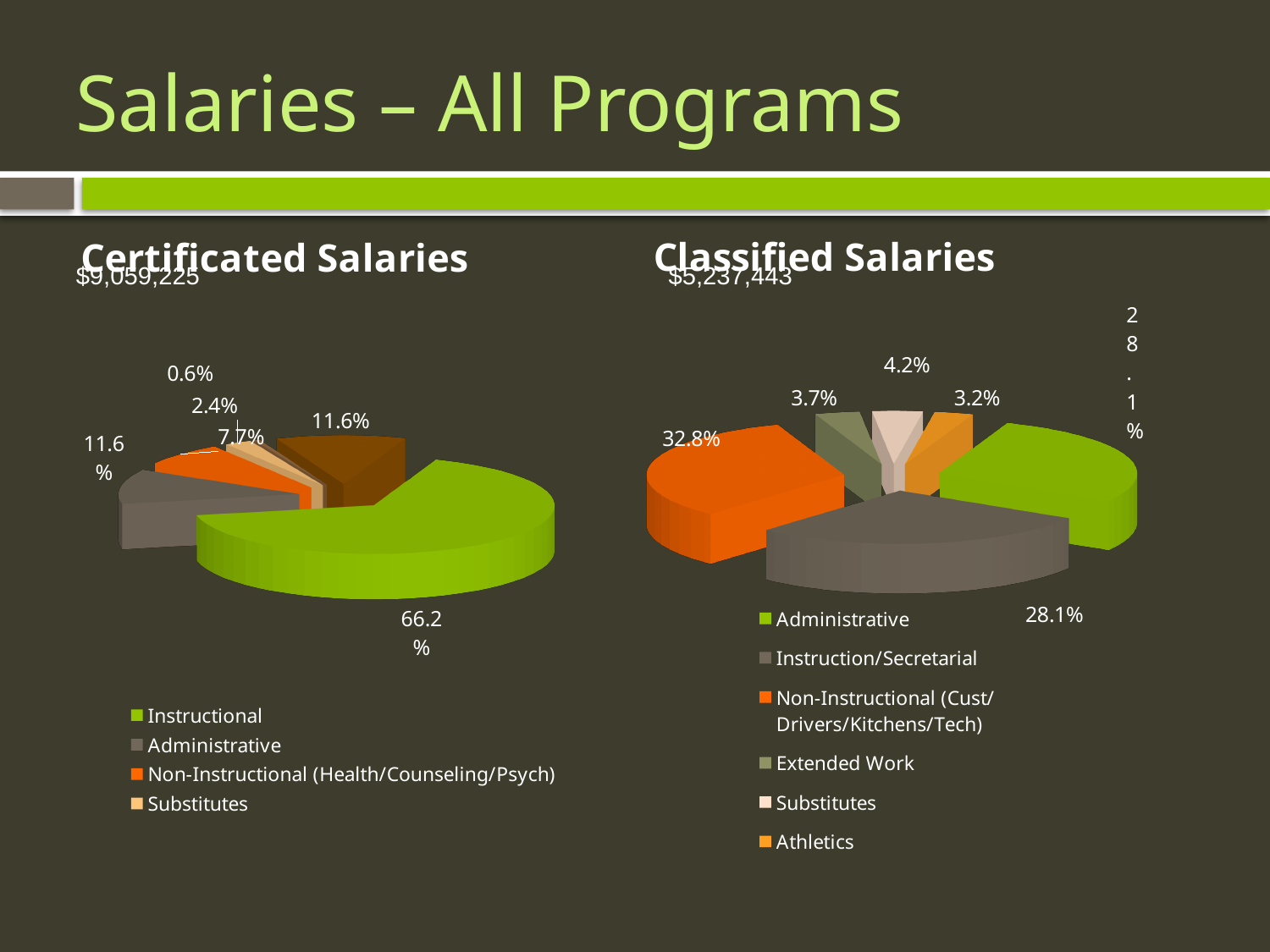
In the Classified Salaries chart, which category has the smallest slice? Athletics In the Certificated Salaries chart, which category has the largest slice? Instructional How many entries does the legend of the Classified Salaries chart list? 6 In the Classified Salaries chart, what share of the pie is Substitutes? 4.2% What kind of chart is used for the Certificated Salaries chart? pie chart In the Classified Salaries chart, how many percentage points larger is the Non-Instructional (Cust/Drivers/Kitchens/Tech) slice than the Administrative slice? 4.7 In the Classified Salaries chart, which category has the largest slice? Non-Instructional (Cust/Drivers/Kitchens/Tech) In the Classified Salaries chart, what share of the pie is Non-Instructional (Cust/Drivers/Kitchens/Tech)? 32.8% What total dollar amount is shown for the Certificated Salaries chart? $9,059,225 In the Certificated Salaries chart, what share of the pie is Instructional? 66.2% What total dollar amount is shown for the Classified Salaries chart? $5,237,443 How many entries does the legend of the Certificated Salaries chart list? 4